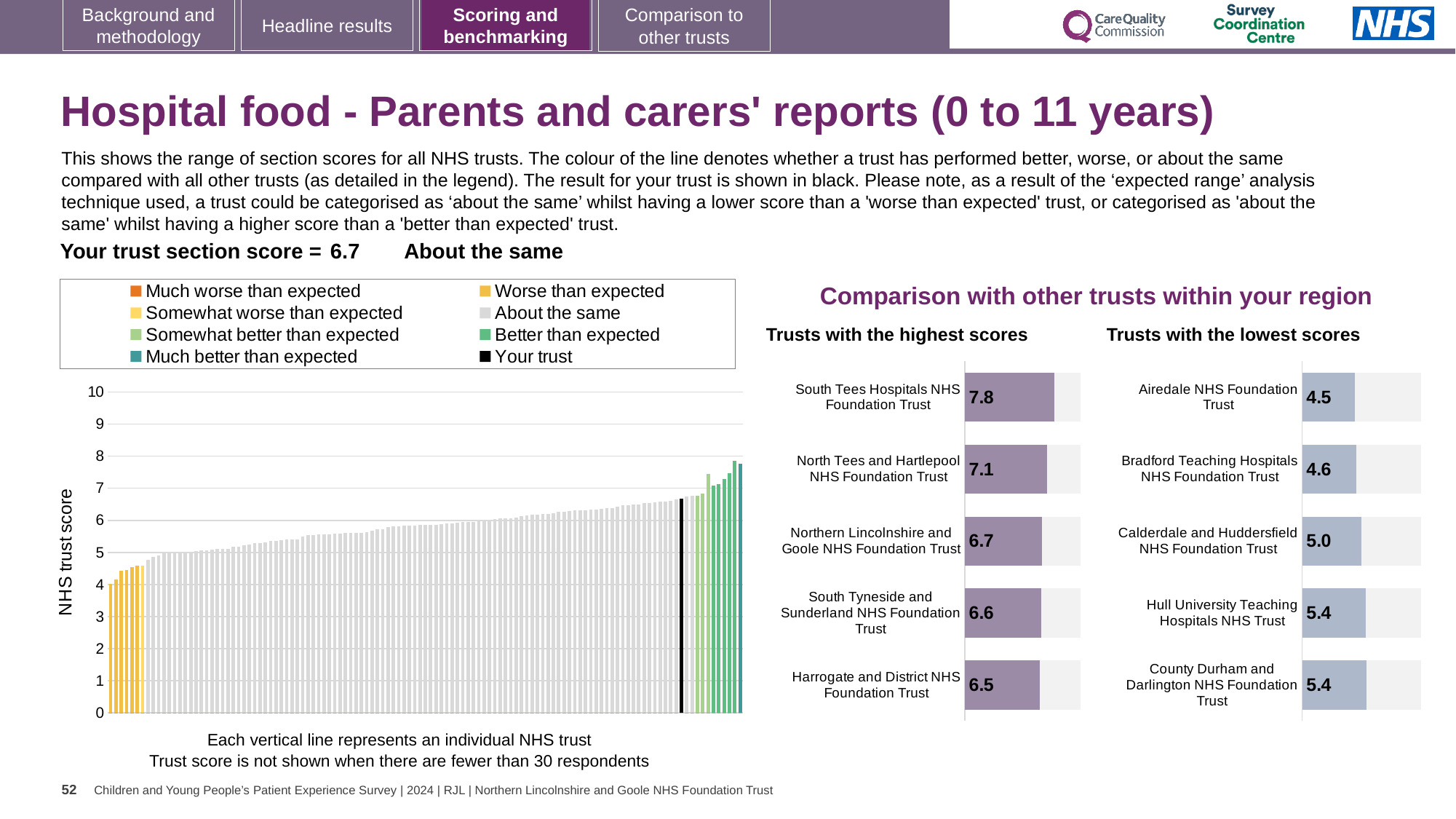
In the 'Trusts with the lowest scores' chart, which trust has the lowest score? Airedale NHS Foundation Trust In the 'Trusts with the lowest scores' chart, what is the score for Calderdale and Huddersfield NHS Foundation Trust? 5.0 In the 'Trusts with the lowest scores' chart, which is larger: the score for Bradford Teaching Hospitals NHS Foundation Trust or Hull University Teaching Hospitals NHS Trust? Hull University Teaching Hospitals NHS Trust In the 'Trusts with the lowest scores' chart, what is the difference between the scores of County Durham and Darlington NHS Foundation Trust and Airedale NHS Foundation Trust? 0.9 In the 'Trusts with the highest scores' chart, what is the score for Harrogate and District NHS Foundation Trust? 6.5 In the large chart on the left, is the value of the black bar (your trust) greater or less than 6? greater In the 'Trusts with the highest scores' chart, what is the difference between the scores of South Tees Hospitals NHS Foundation Trust and North Tees and Hartlepool NHS Foundation Trust? 0.7 In the 'Trusts with the highest scores' chart, what is the score for South Tees Hospitals NHS Foundation Trust? 7.8 How many entries does the legend of the large chart on the left list? 8 What type of chart is the large chart on the left showing NHS trust scores? Bar chart In the large chart on the left, do the trust scores rise or fall from left to right? Rise How many trusts are listed in the 'Trusts with the highest scores' chart? 5